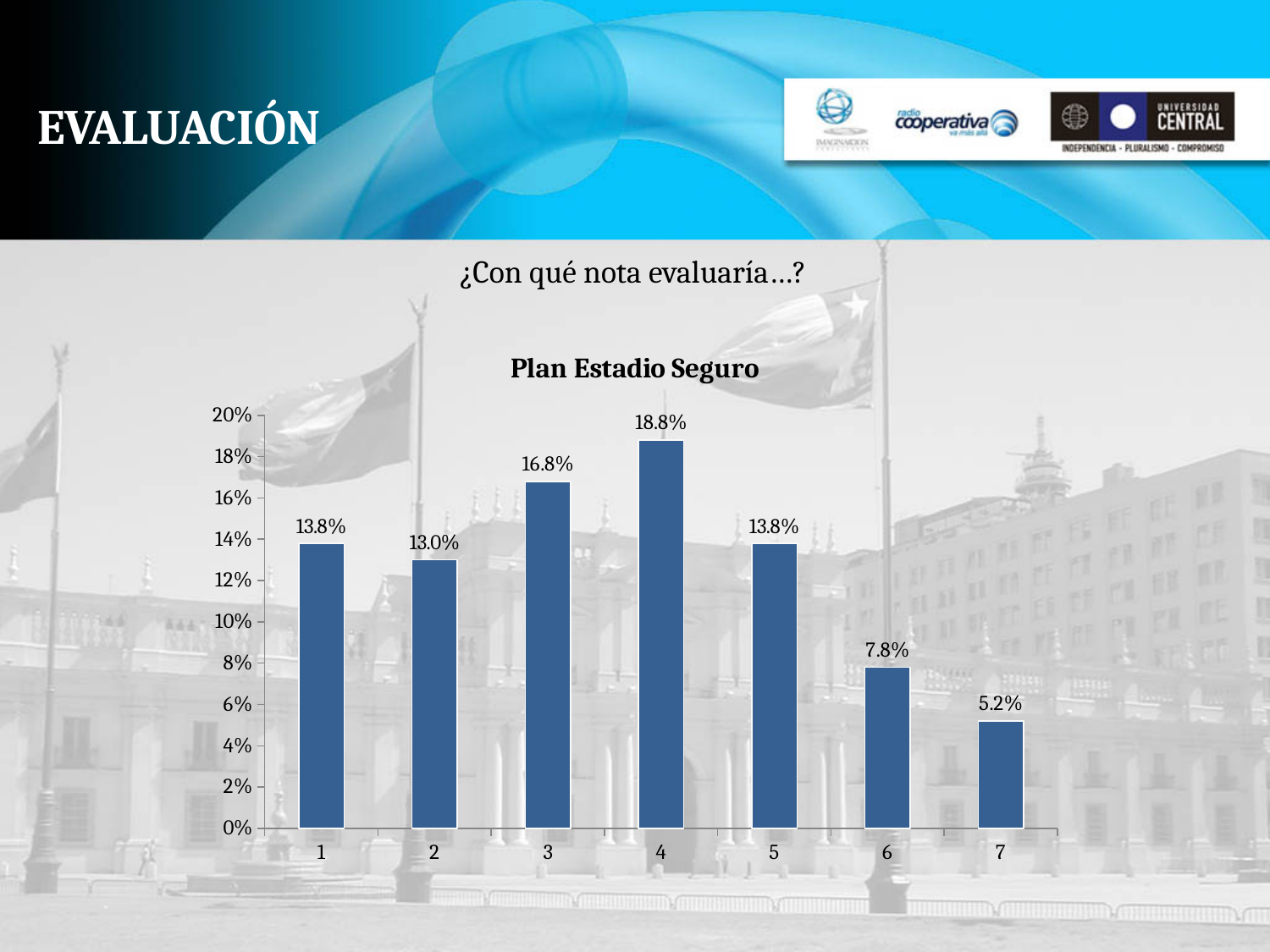
What is the difference between the values for categories 6 and 7 in the Plan Estadio Seguro chart? 2.6% Which category has the highest value in the Plan Estadio Seguro chart? 4 Which category has the lowest value in the Plan Estadio Seguro chart? 7 What is the value for category 4 in the Plan Estadio Seguro chart? 18.8% What is the difference between the values for categories 4 and 3 in the Plan Estadio Seguro chart? 2.0% What is the title of the chart on the slide? Plan Estadio Seguro Which is larger in the Plan Estadio Seguro chart, the value for category 3 or category 5? 3 What kind of chart is the Plan Estadio Seguro chart? bar chart Is the value for category 6 greater or less than 10% in the Plan Estadio Seguro chart? less What is the value for category 7 in the Plan Estadio Seguro chart? 5.2% How many categories are shown in the Plan Estadio Seguro chart? 7 What is the value for category 2 in the Plan Estadio Seguro chart? 13.0%